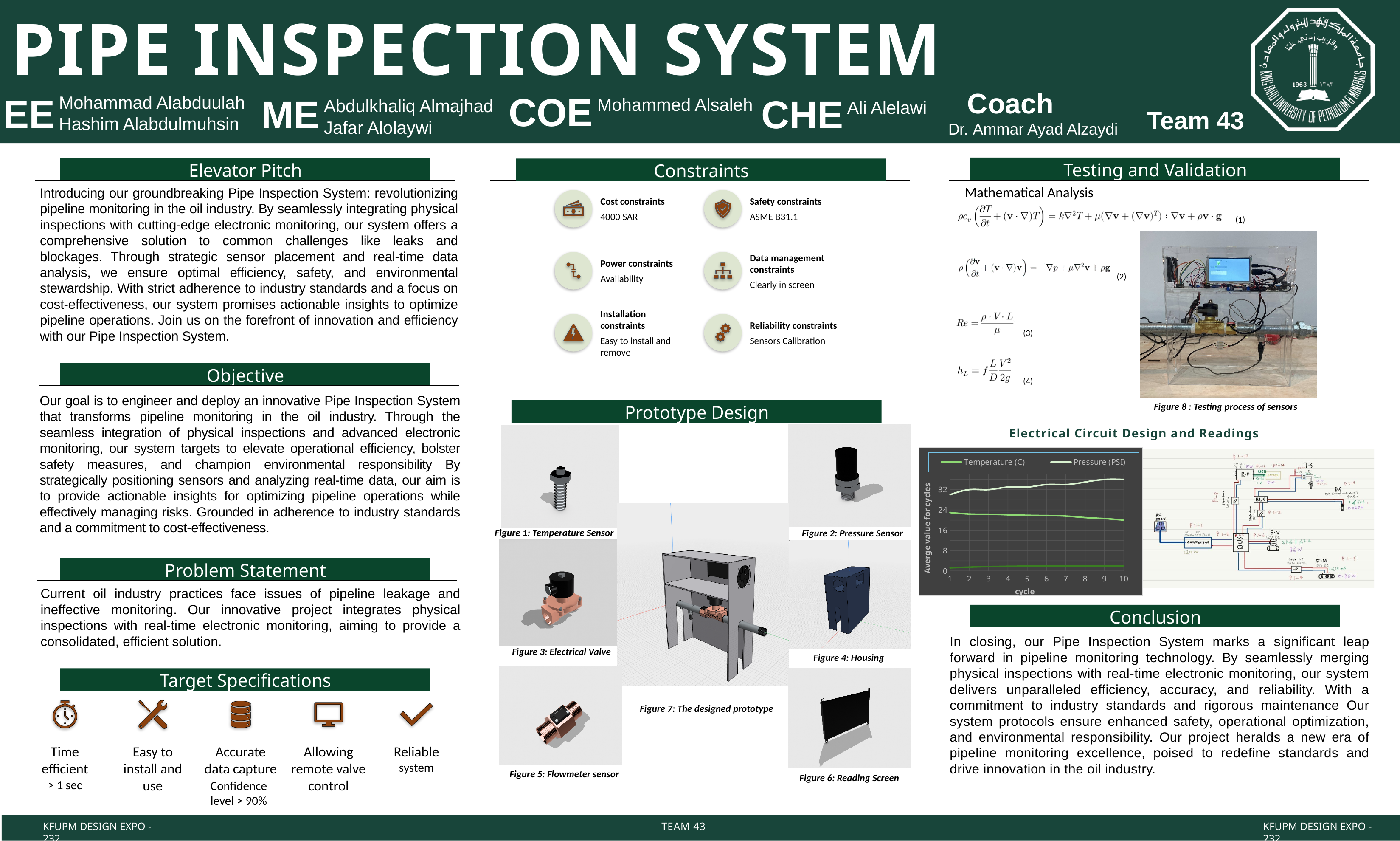
Is the Temperature (C) value at cycle 10 greater or less than 24? less Which series has the higher values across all cycles in the line chart? Pressure (PSI) At cycle 5, which series has the larger value, Temperature (C) or Pressure (PSI)? Pressure (PSI) What are the two series named in the legend of the line chart? Temperature (C) and Pressure (PSI) Does the Temperature (C) series rise or fall from cycle 1 to cycle 10? fall How many cycles are plotted along the x axis of the line chart? 10 What is the title of the x axis of the line chart? cycle How many series does the legend of the line chart list? 2 Does the Pressure (PSI) series rise or fall from cycle 1 to cycle 10? rise Is the Temperature (C) value at cycle 1 greater or less than 16? greater What kind of chart is shown under 'Electrical Circuit Design and Readings'? line chart Is the Pressure (PSI) value at cycle 10 greater or less than 32? greater